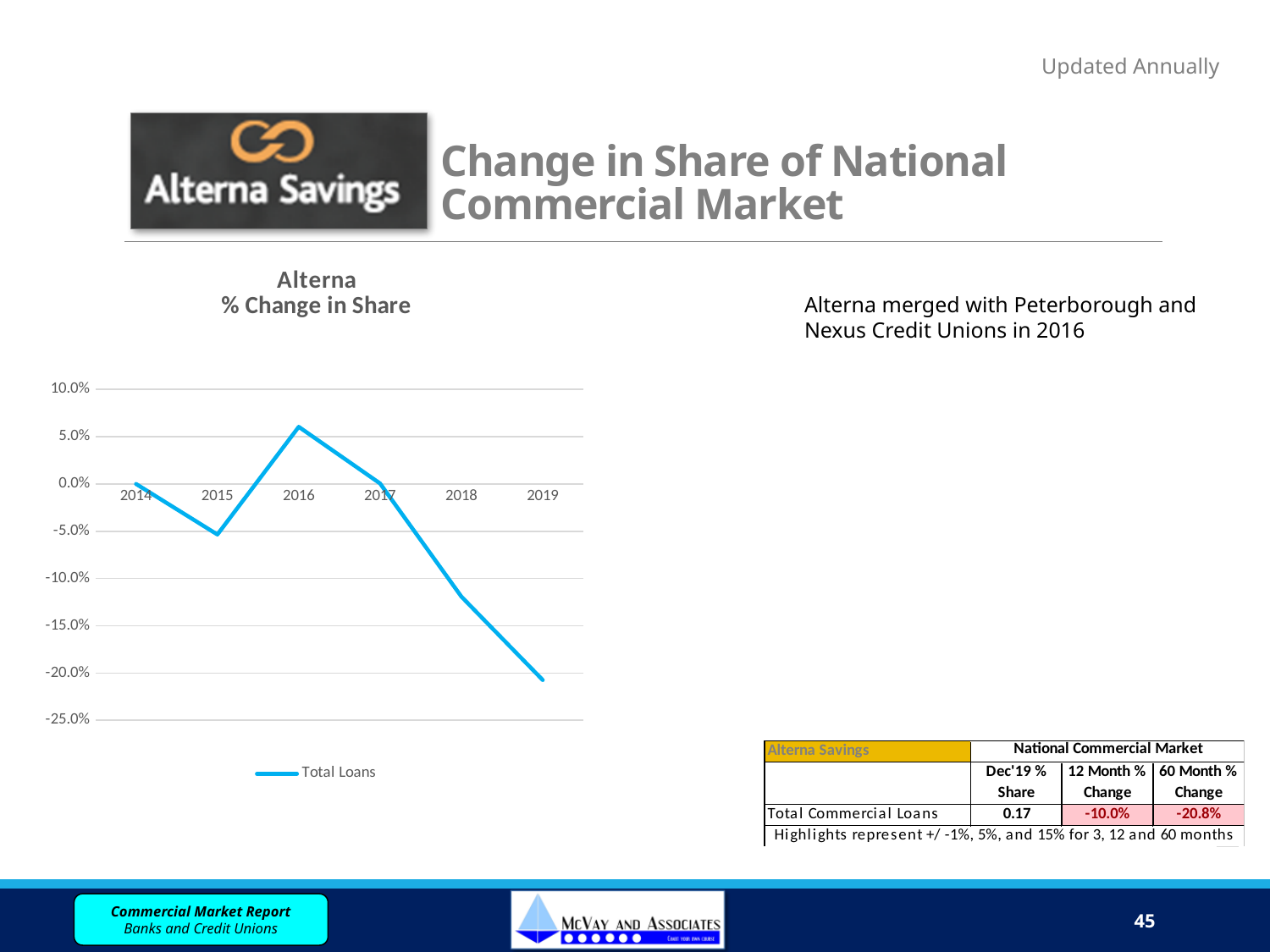
In which year is the % change in share lowest? 2019 What kind of chart is shown on the slide? line chart How many years are plotted on the x axis of the chart? 6 What is the name of the series shown in the chart legend? Total Loans Is the value for 2019 greater or less than -15.0%? less Is the value for 2016 greater or less than 5.0%? greater Do the values rise or fall from 2017 to 2019? fall How many series does the chart legend list? 1 Which year has the larger % change in share, 2015 or 2016? 2016 Is the value for 2018 greater or less than -10.0%? less In which year is the % change in share highest? 2016